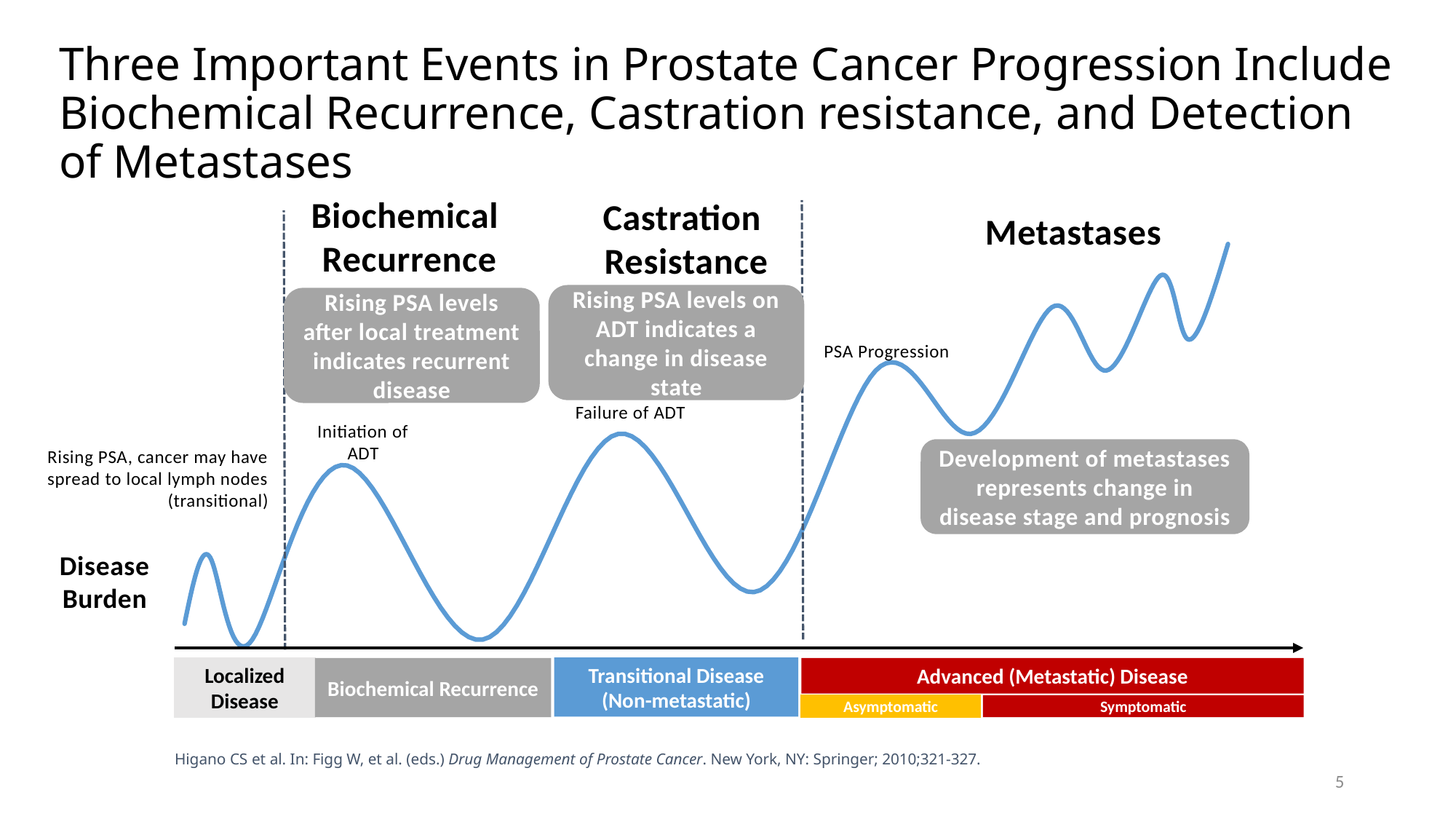
Into which two sub-stages is the Advanced (Metastatic) Disease stage divided on the x axis? Asymptomatic and Symptomatic How many important events are labelled above the curve (Biochemical Recurrence, Castration Resistance, Metastases)? 3 Of the three labelled points on the curve (Initiation of ADT, Failure of ADT, PSA Progression), which has the lowest disease burden? Initiation of ADT What kind of chart is shown on the slide? line chart Overall, does disease burden rise or fall from left to right along the x axis? rise Which labelled point on the curve has the higher disease burden, PSA Progression or Initiation of ADT? PSA Progression Which labelled point on the curve has the higher disease burden, Initiation of ADT or Failure of ADT? Failure of ADT What quantity is plotted on the vertical axis of the chart? Disease Burden In which disease stage along the x axis does the curve reach its highest disease burden? Advanced (Metastatic) Disease Of the three labelled points on the curve (Initiation of ADT, Failure of ADT, PSA Progression), which has the highest disease burden? PSA Progression How many disease stages are labelled along the x axis of the chart? 4